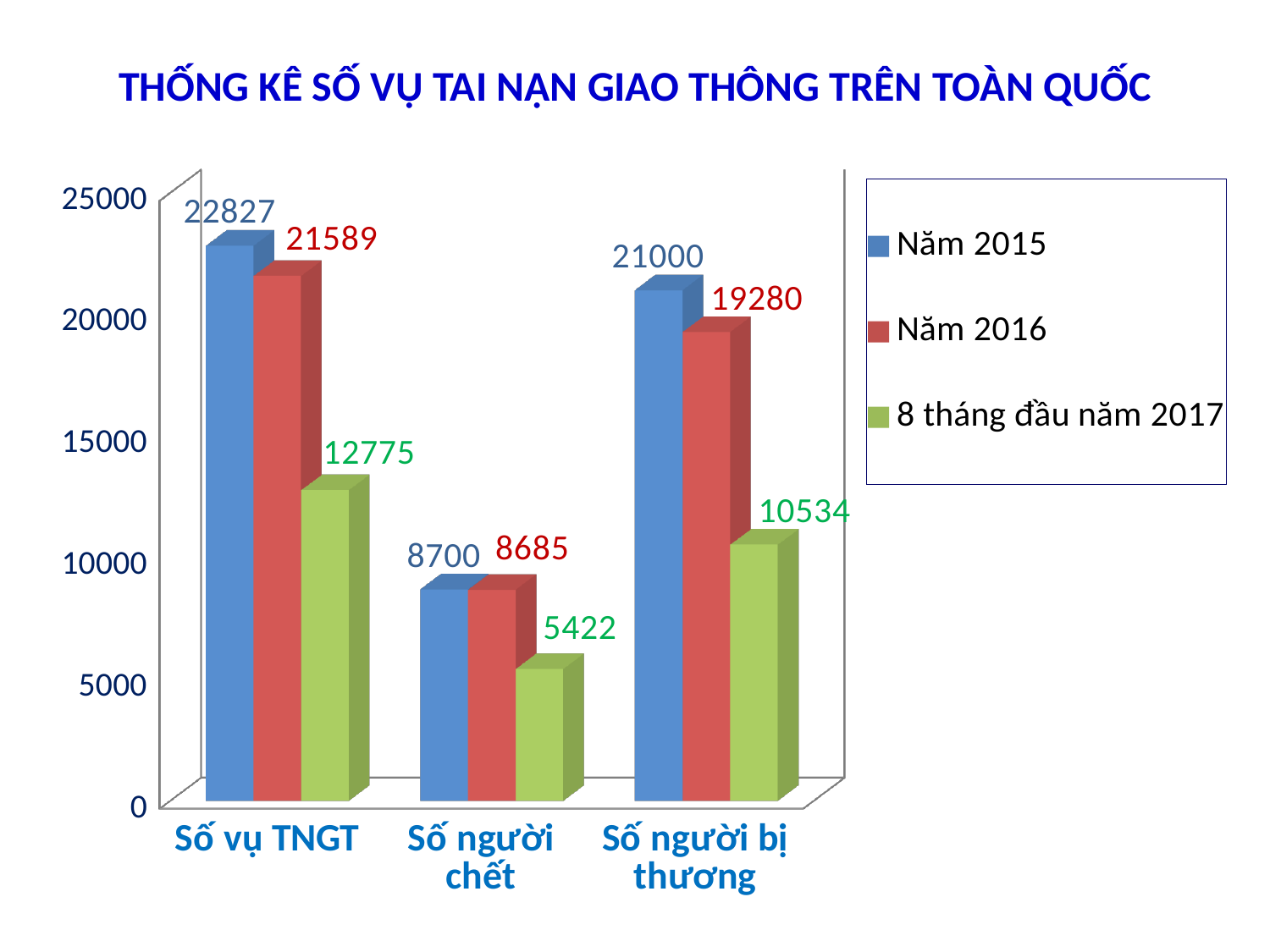
What is the title of the chart? THỐNG KÊ SỐ VỤ TAI NẠN GIAO THÔNG TRÊN TOÀN QUỐC Which is larger: the Năm 2015 value for Số người bị thương or the Năm 2016 value for Số vụ TNGT? Năm 2016 value for Số vụ TNGT What is the value for Số vụ TNGT in Năm 2015? 22827 What is the value for Số người chết in Năm 2016? 8685 What is the difference between the Năm 2016 and 8 tháng đầu năm 2017 values for Số người bị thương? 8746 Which category has the lowest value in the 8 tháng đầu năm 2017 series? Số người chết Which category has the highest value in the Năm 2016 series? Số vụ TNGT What is the value for Số người bị thương in 8 tháng đầu năm 2017? 10534 What is the difference between the Năm 2015 and Năm 2016 values for Số vụ TNGT? 1238 How many series does the legend list? 3 How many categories are shown on the x axis? 3 What kind of chart is shown on the slide? Bar chart